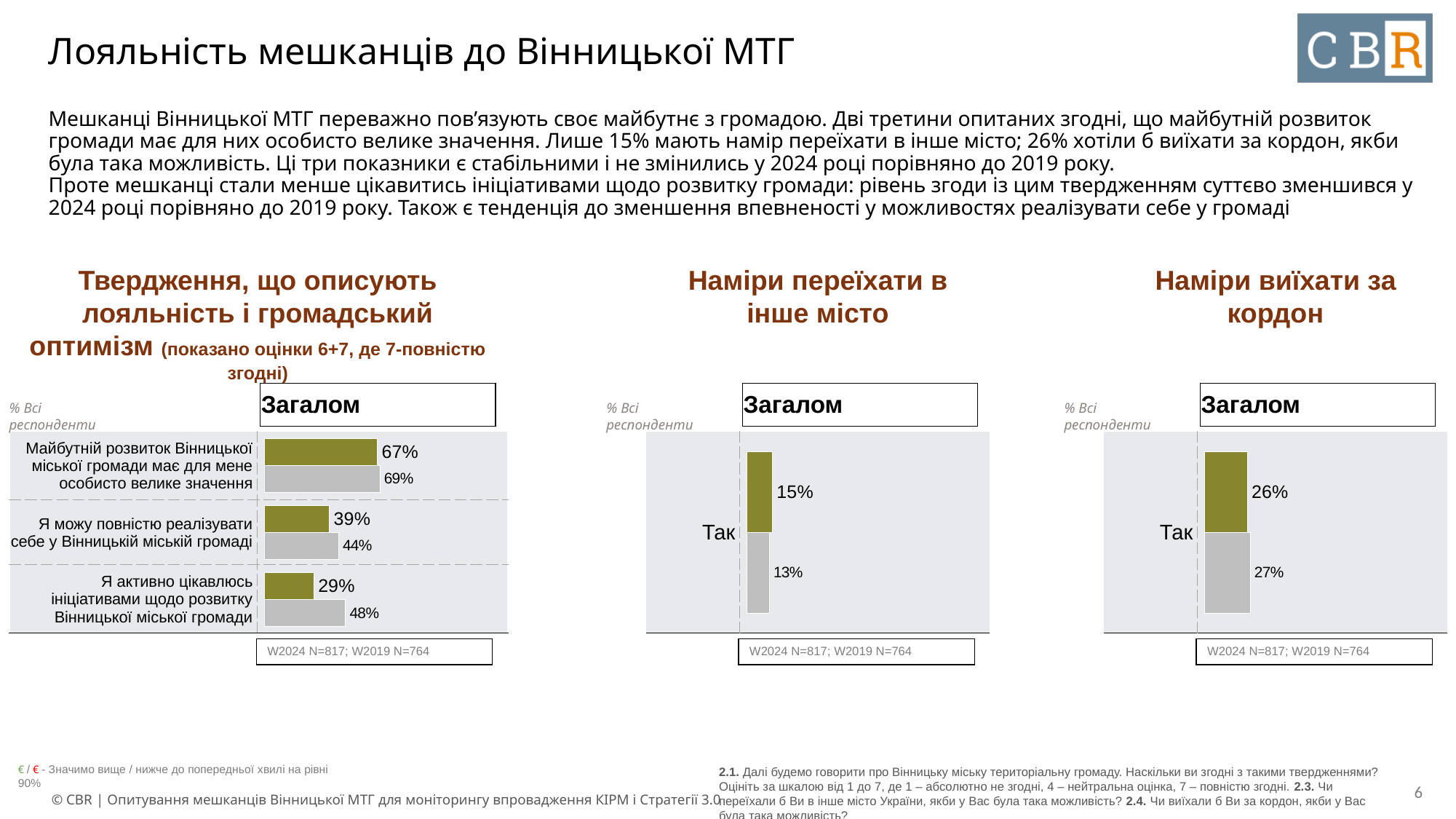
In the chart 'Твердження, що описують лояльність і громадський оптимізм', what is the difference between the grey bar (48%) and the olive bar (29%) for 'Я активно цікавлюсь ініціативами щодо розвитку Вінницької міської громади'? 19 percentage points In the chart 'Твердження, що описують лояльність і громадський оптимізм', what is the value of the grey (lower) bar for 'Я активно цікавлюсь ініціативами щодо розвитку Вінницької міської громади'? 48% In the chart 'Твердження, що описують лояльність і громадський оптимізм', what is the value of the olive (upper) bar for 'Майбутній розвиток Вінницької міської громади має для мене особисто велике значення'? 67% In the chart 'Твердження, що описують лояльність і громадський оптимізм', which statement has the highest olive (upper) bar value? Майбутній розвиток Вінницької міської громади має для мене особисто велике значення How many statements (categories) are shown in the chart 'Твердження, що описують лояльність і громадський оптимізм'? 3 In the chart 'Наміри переїхати в інше місто', what is the value of the grey (lower) bar for 'Так'? 13% In the chart 'Наміри переїхати в інше місто', what is the value of the olive (upper) bar for 'Так'? 15% In the chart 'Твердження, що описують лояльність і громадський оптимізм', which statement has the lowest olive (upper) bar value? Я активно цікавлюсь ініціативами щодо розвитку Вінницької міської громади What type of chart is 'Наміри виїхати за кордон'? bar chart In the chart 'Наміри виїхати за кордон', which bar is larger for 'Так': the olive (upper) bar or the grey (lower) bar? the grey (lower) bar In the chart 'Наміри виїхати за кордон', what is the value of the olive (upper) bar for 'Так'? 26% In the chart 'Твердження, що описують лояльність і громадський оптимізм', what is the value of the olive (upper) bar for 'Я можу повністю реалізувати себе у Вінницькій міській громаді'? 39%